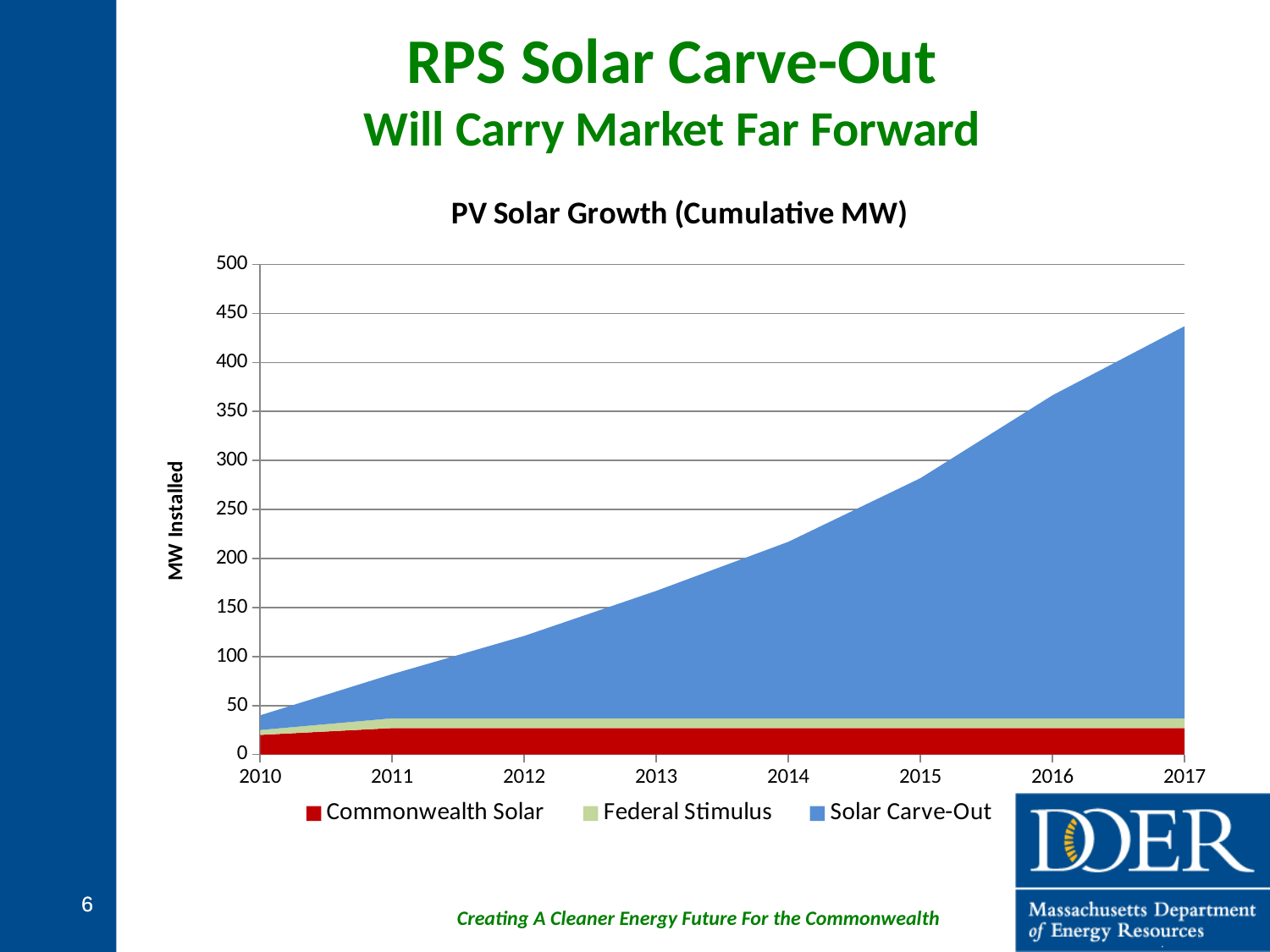
Is the total cumulative MW installed in 2014 greater or less than 200? greater How many series does the legend list? 3 Does the total cumulative MW rise or fall from 2010 to 2017? Rise Is the total cumulative MW installed in 2017 greater or less than 400? greater In which year is the total cumulative MW installed lowest? 2010 Is the total cumulative MW installed in 2010 greater or less than 50? less Which series accounts for the larger share of the total in 2017, Solar Carve-Out or Commonwealth Solar? Solar Carve-Out How many years are shown along the x axis? 8 What is the title of the chart? PV Solar Growth (Cumulative MW) What is the label on the vertical axis? MW Installed In which year is the total cumulative MW installed highest? 2017 What kind of chart is shown on the slide? Stacked area chart